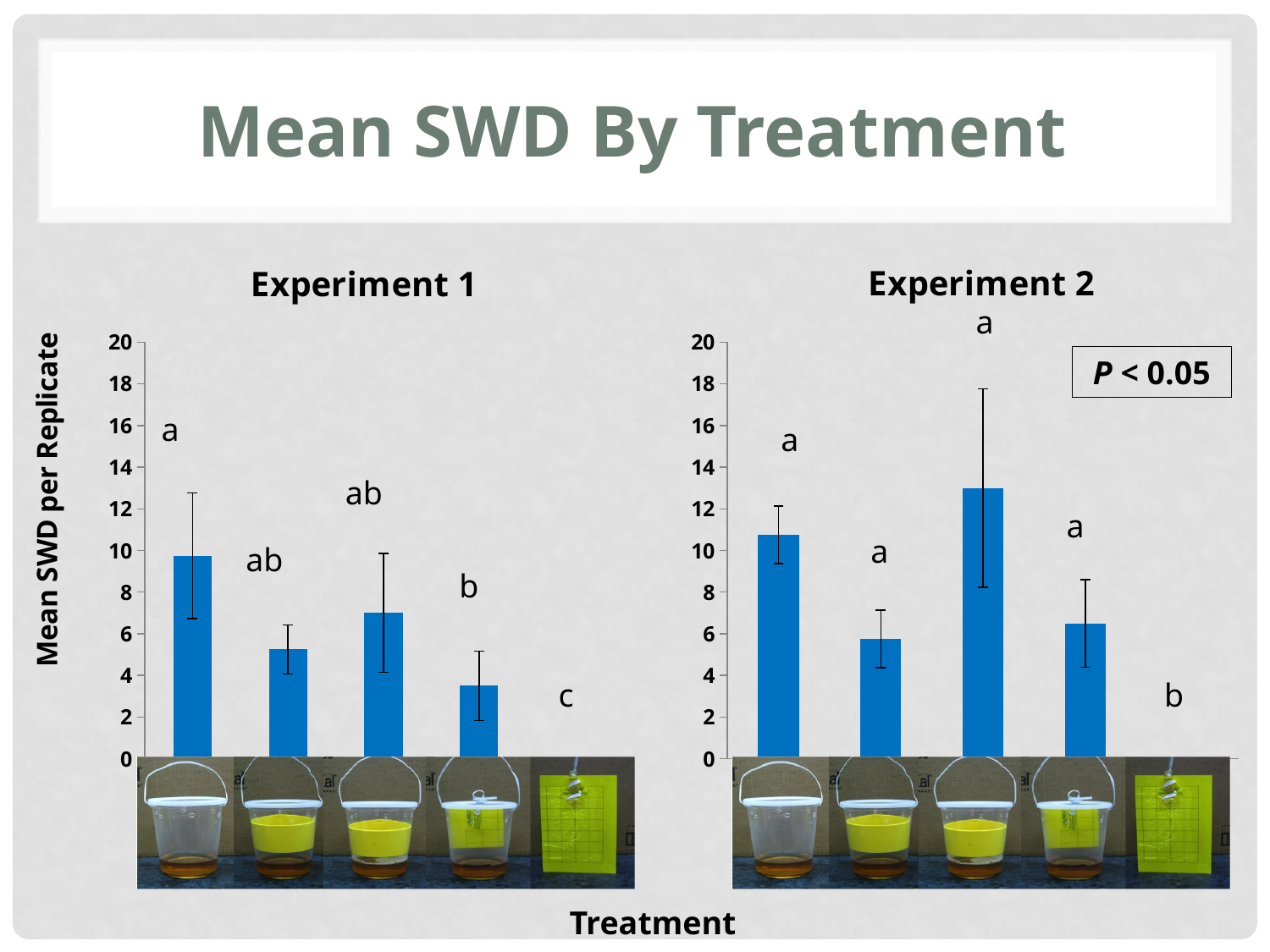
In the Experiment 1 chart, which bar is the highest? the first (leftmost) bar In the Experiment 2 chart, which bar is the highest? the third bar In the Experiment 1 chart, is the value of the first bar greater or less than 8? greater In the Experiment 1 chart, which of the four plotted bars is the lowest? the fourth bar In the Experiment 2 chart, is the value of the third bar greater or less than 12? greater In the Experiment 2 chart, is the value of the second bar greater or less than 8? less What kind of chart is used for Experiment 1? bar chart How many bars are plotted in the Experiment 2 chart? 4 What is the y-axis title shared by the two charts? Mean SWD per Replicate In the Experiment 2 chart, which is larger, the first bar or the fourth bar? the first bar In the Experiment 1 chart, which is larger, the second bar or the third bar? the third bar